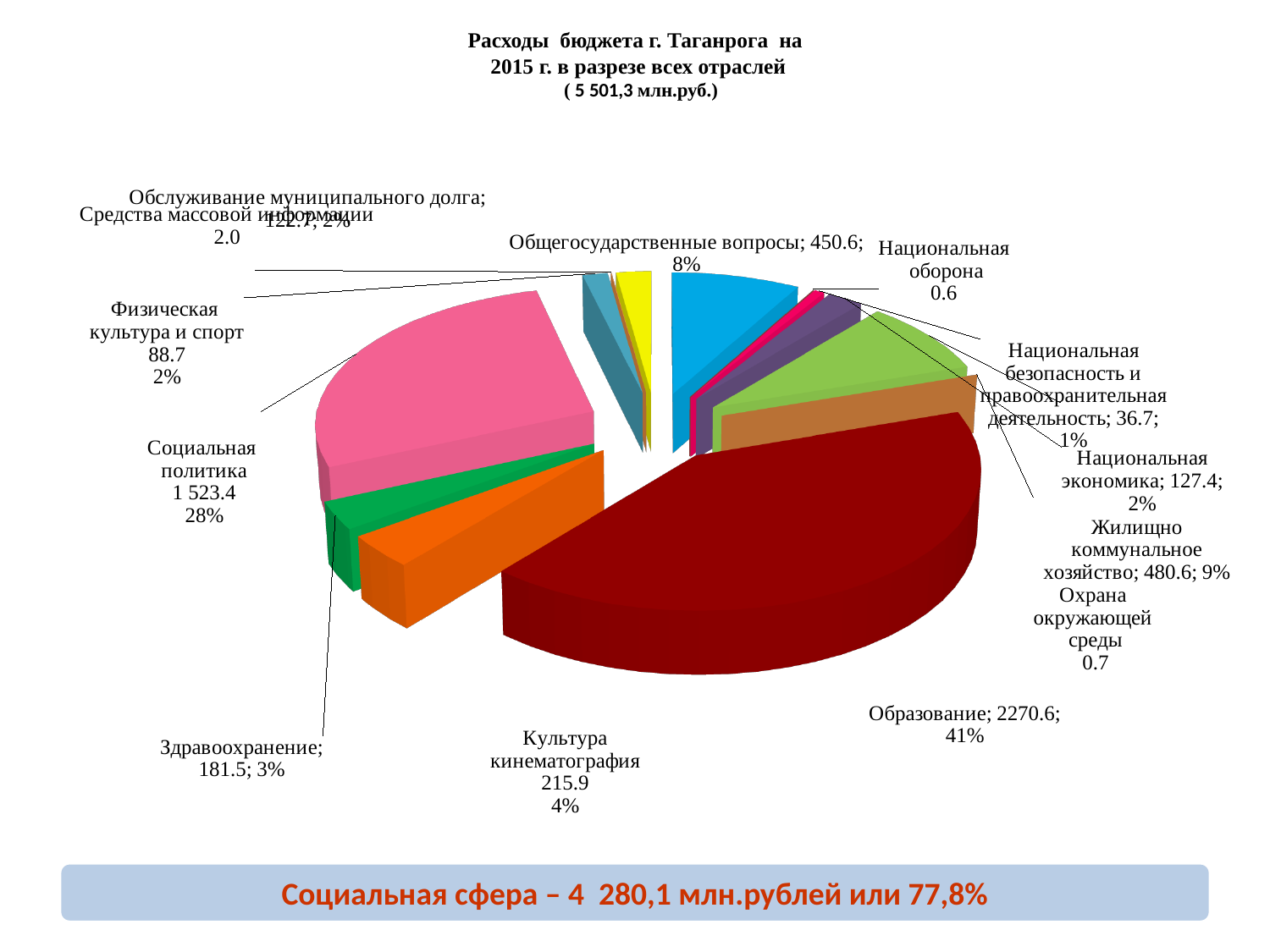
What is the value for Образование? 2270.6 What total amount in million rubles is given in the chart title? 5 501,3 млн.руб. What share of the pie does Социальная политика represent? 28% Which category has the smallest value? Национальная оборона What is the value for Жилищно коммунальное хозяйство? 480.6 What is the difference between the values for Образование and Социальная политика? 747.2 What share of the pie does Образование represent? 41% Which is larger, Общегосударственные вопросы or Жилищно коммунальное хозяйство? Жилищно коммунальное хозяйство What is the value for Здравоохранение? 181.5 Which category has the largest slice of the pie? Образование What kind of chart is shown on the slide? pie chart What is the value for Социальная политика? 1 523.4